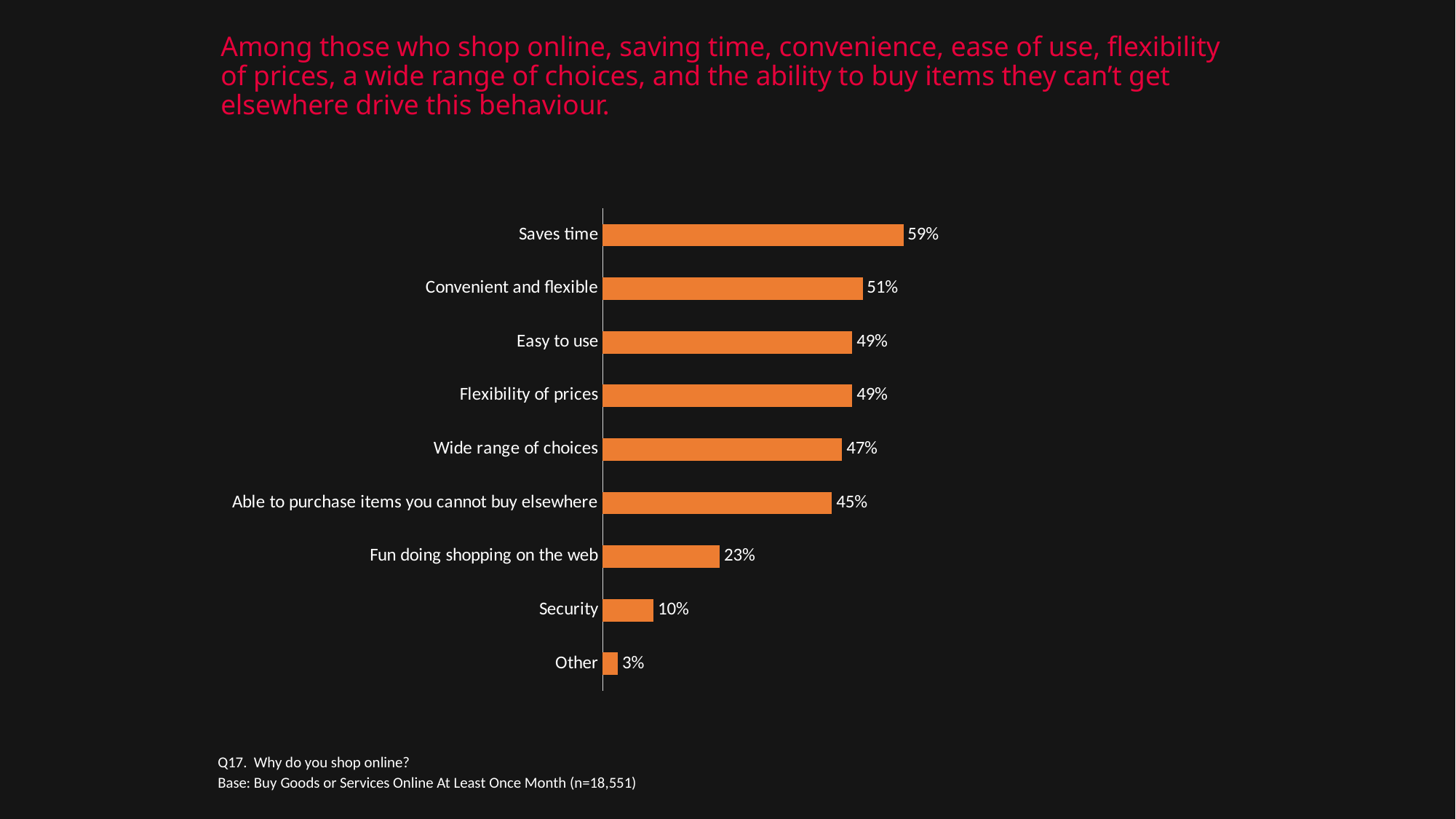
What kind of chart is shown on the slide? Bar chart What is the value for 'Able to purchase items you cannot buy elsewhere'? 45% How many categories are shown in the bar chart? 9 What is the value for 'Security'? 10% What is the difference between 'Fun doing shopping on the web' and 'Security'? 13% Which is larger, 'Wide range of choices' or 'Fun doing shopping on the web'? Wide range of choices Which category has the lowest value? Other What is the difference between 'Saves time' and 'Convenient and flexible'? 8% What colour are the bars in the chart? Orange Which reason for shopping online has the highest percentage? Saves time What is the value for 'Easy to use'? 49% What percentage of online shoppers say they shop online because it saves time? 59%